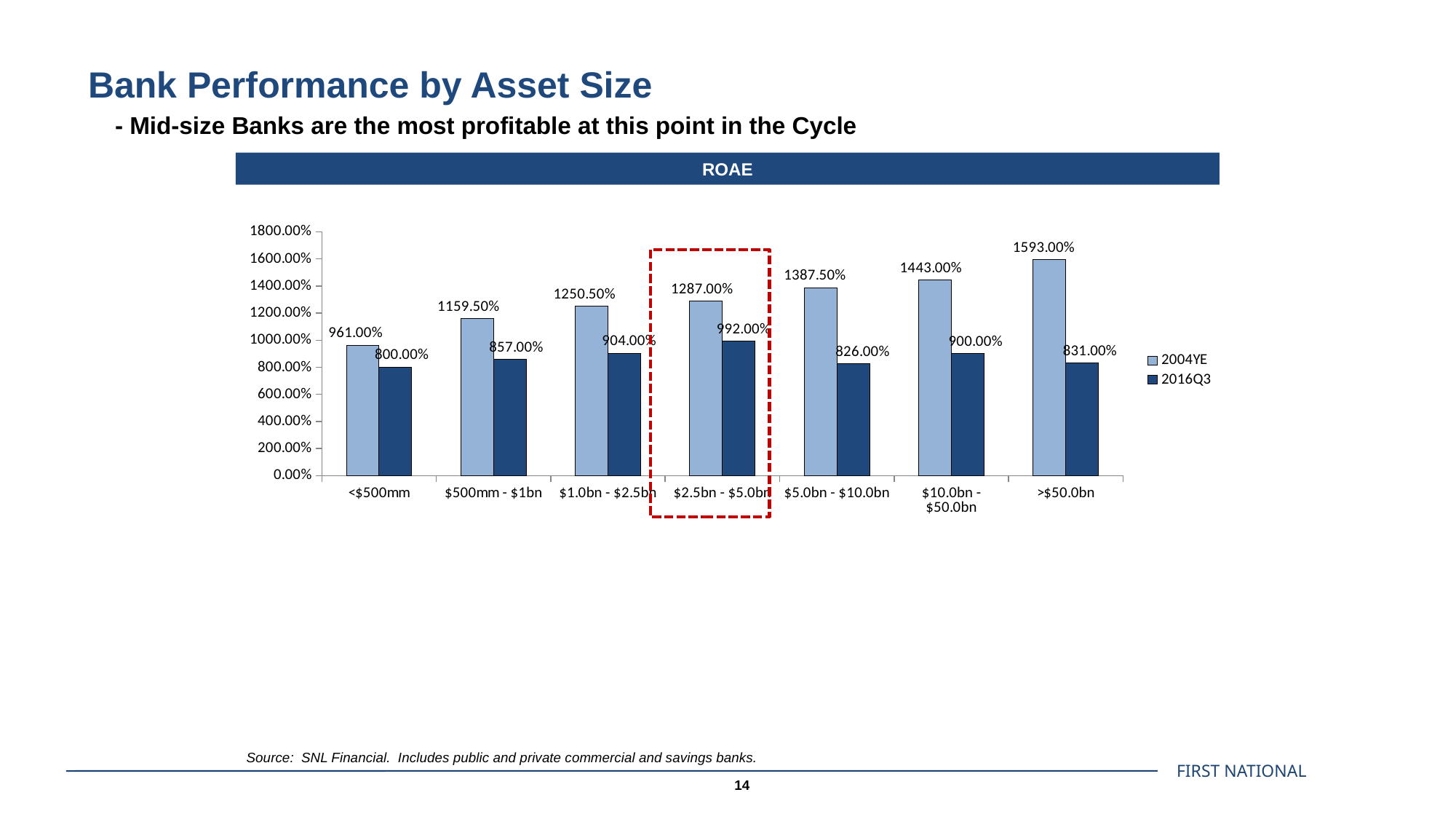
What is the 2004YE ROAE value for the $2.5bn - $5.0bn asset size category? 1287.00% What is the 2016Q3 ROAE value for the $1.0bn - $2.5bn category? 904.00% Which asset size category has the lowest 2016Q3 ROAE value? <$500mm What kind of chart is used to show ROAE by asset size? Bar chart Which is larger: the 2016Q3 ROAE for $10.0bn - $50.0bn or the 2016Q3 ROAE for $5.0bn - $10.0bn? $10.0bn - $50.0bn Which asset size category has the highest 2016Q3 ROAE value? $2.5bn - $5.0bn How many series does the legend of the ROAE chart list? 2 What is the 2016Q3 ROAE value for the >$50.0bn asset size category? 831.00% Do the 2004YE ROAE values rise or fall as asset size increases along the x axis? Rise How many asset size categories are shown on the x axis of the ROAE chart? 7 What is the difference between the 2004YE and 2016Q3 ROAE values for the <$500mm category? 161.00% Which asset size category has the highest 2004YE ROAE value? >$50.0bn